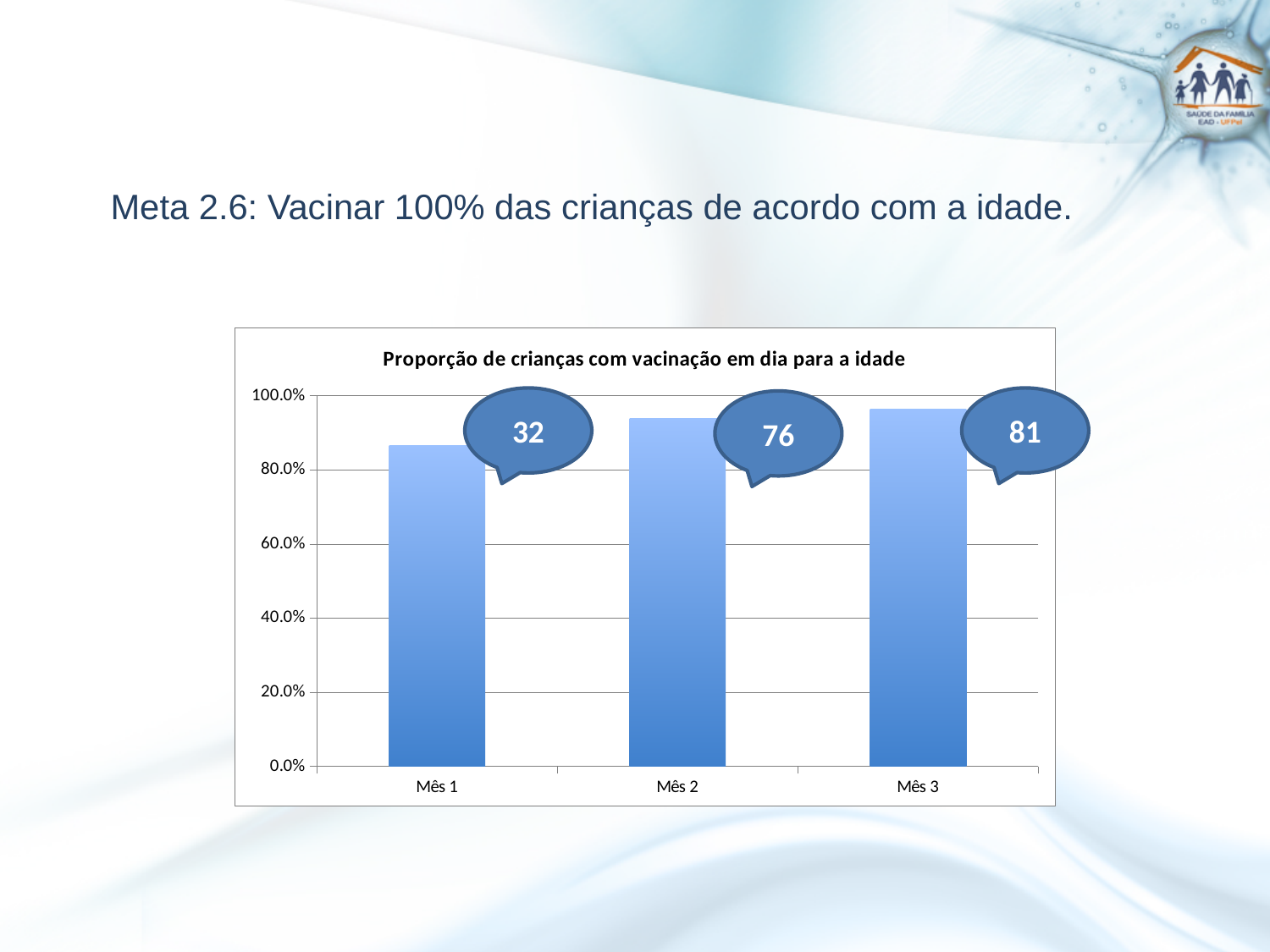
Is the value for Mês 1 greater or less than 80.0%? greater How many categories (months) are plotted on the x axis? 3 Which bar is taller, Mês 1 or Mês 3? Mês 3 What number is shown in the callout bubble next to the Mês 2 bar? 76 What kind of chart is shown on the slide? bar chart Is the value for Mês 3 greater or less than 100.0%? less Do the bar values rise or fall from Mês 1 to Mês 3? rise Which month has the lowest bar? Mês 1 Which bar is taller, Mês 1 or Mês 2? Mês 2 Is the value for Mês 2 greater or less than 80.0%? greater What is the title of the chart? Proporção de crianças com vacinação em dia para a idade